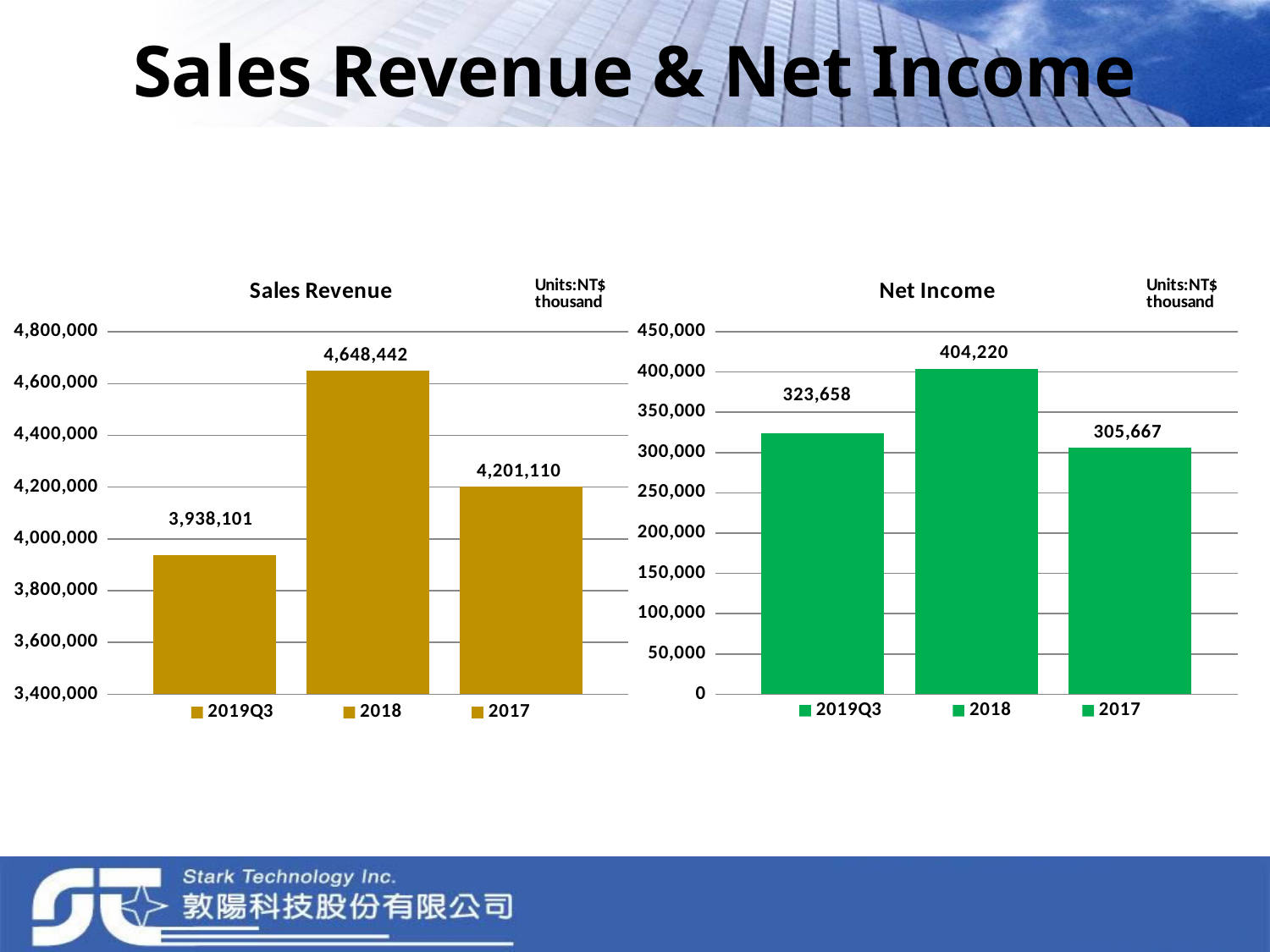
In the Net Income chart, what is the difference between the 2018 and 2019Q3 values? 80,562 What unit is stated for the values in the Net Income chart? NT$ thousand In the Sales Revenue chart, is the value for 2017 greater or less than 4,000,000? greater In the Net Income chart, which is larger, the value for 2019Q3 or the value for 2017? 2019Q3 In the Net Income chart, which year has the highest net income? 2018 In the Sales Revenue chart, what is the value for 2018? 4,648,442 In the Sales Revenue chart, what is the difference between the 2018 and 2017 values? 447,332 How many bars are plotted in the Net Income chart? 3 What kind of chart is the Sales Revenue chart? bar chart In the Sales Revenue chart, which period has the lowest sales revenue? 2019Q3 In the Net Income chart, what is the value for 2017? 305,667 In the Sales Revenue chart, what is the value for 2019Q3? 3,938,101